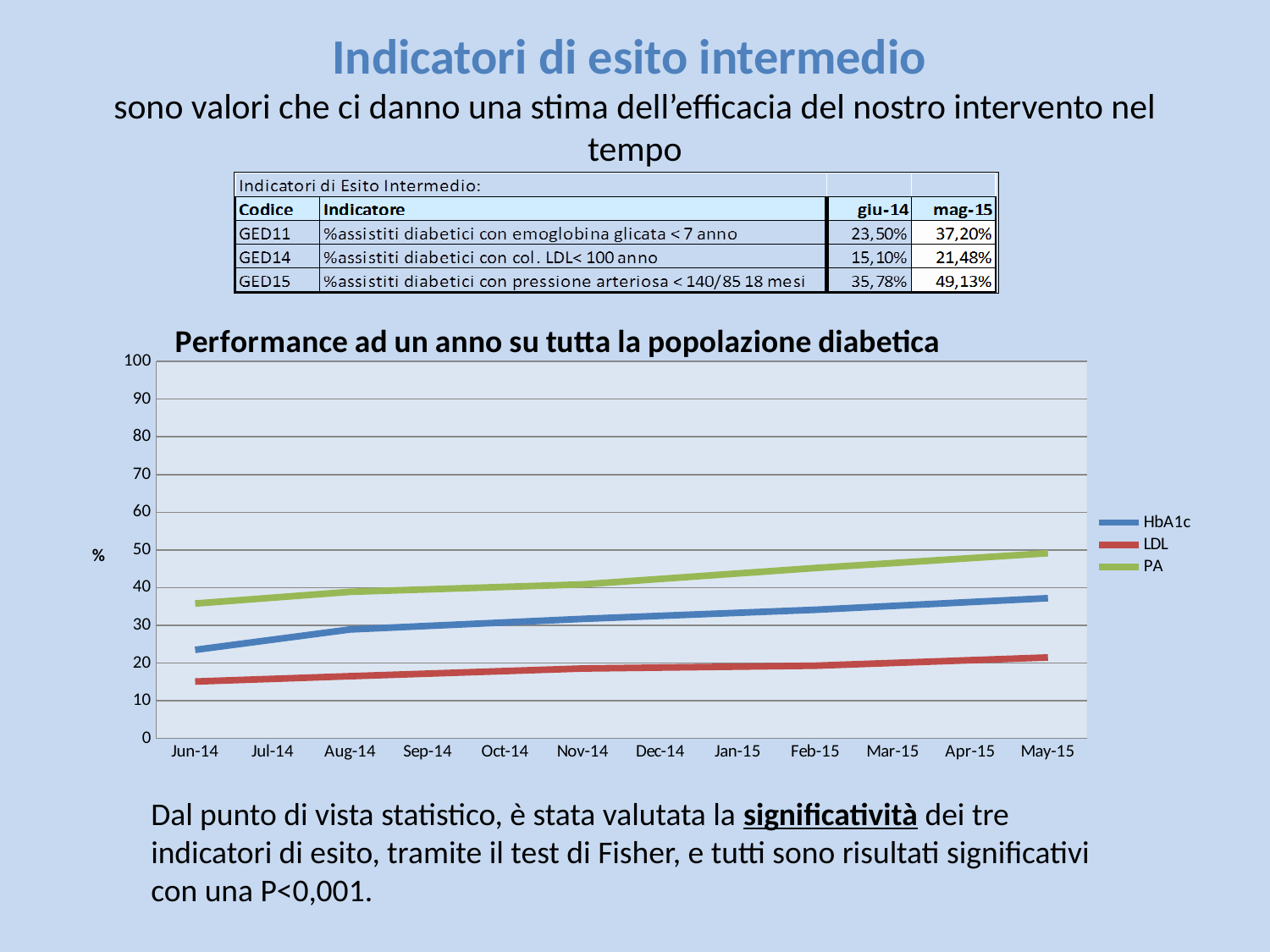
Which series has the highest value at May-15? PA Does the PA line rise or fall from Jun-14 to May-15? rise What is the title of the chart? Performance ad un anno su tutta la popolazione diabetica Is the value for PA at May-15 greater or less than 40? greater Which series has the lowest value at Jun-14? LDL What kind of chart is shown on the slide? line chart What label is shown on the vertical axis of the chart? % Is the value for LDL at Jun-14 greater or less than 20? less How many series does the chart legend list? 3 How many months are shown along the x axis of the chart? 12 At Dec-14, which series has the larger value, HbA1c or LDL? HbA1c Does the HbA1c line rise or fall from Jun-14 to May-15? rise